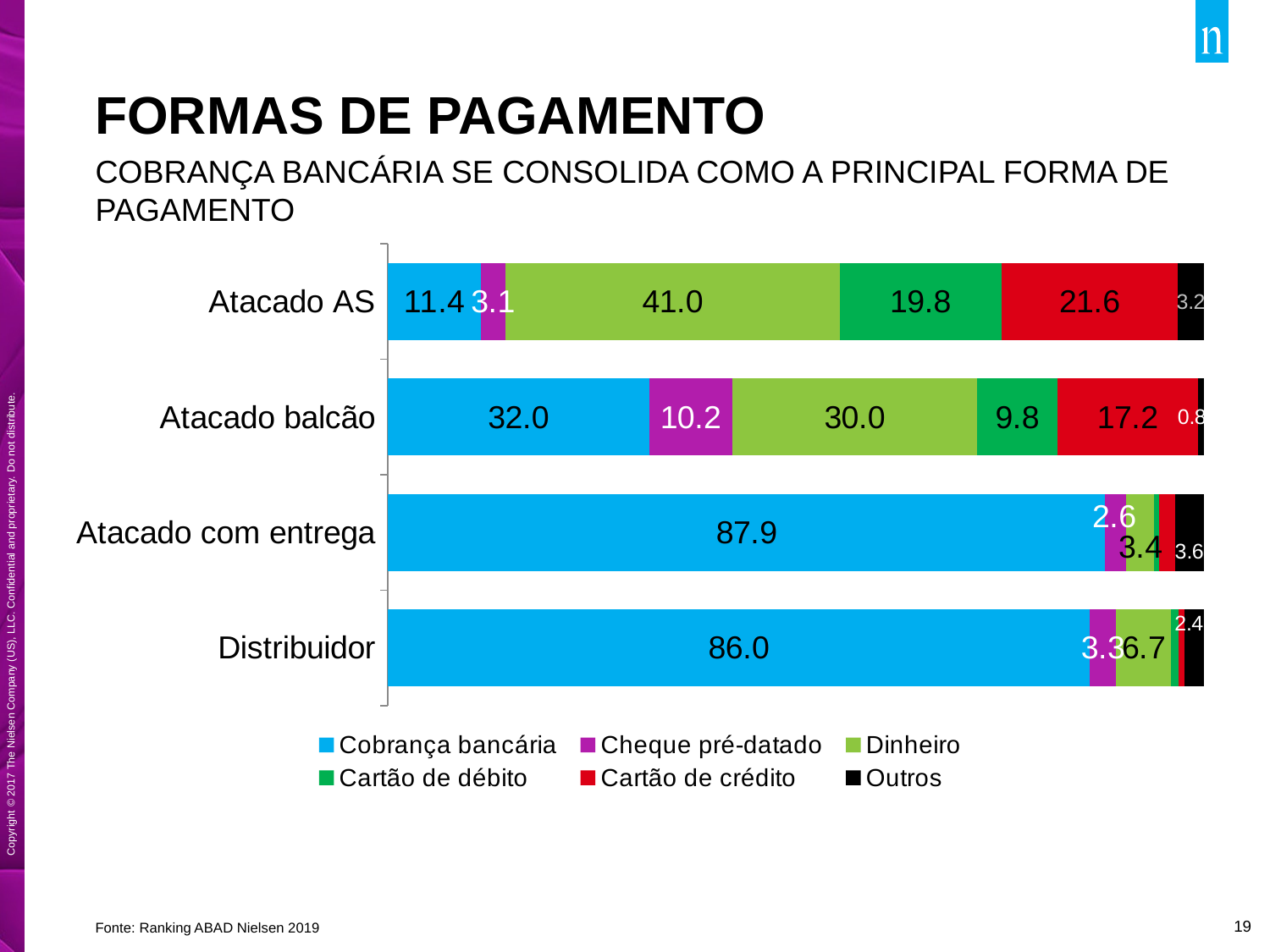
What is the value for Cartão de crédito in the Atacado AS category? 21.6 How many series does the legend list? 6 Which category has the highest value for Cobrança bancária? Atacado com entrega Which is larger: Cartão de débito for Atacado AS or Cartão de débito for Atacado balcão? Atacado AS What is the value for Dinheiro in the Atacado AS category? 41.0 What is the difference between the Dinheiro values for Atacado AS and Atacado balcão? 11.0 What is the value for Cobrança bancária in the Atacado com entrega category? 87.9 Which category has the lowest value for Cobrança bancária? Atacado AS What is the value for Cheque pré-datado in the Atacado balcão category? 10.2 What is the value for Outros in the Distribuidor category? 2.4 How many categories are shown on the chart? 4 What kind of chart is shown on the slide? Stacked bar chart